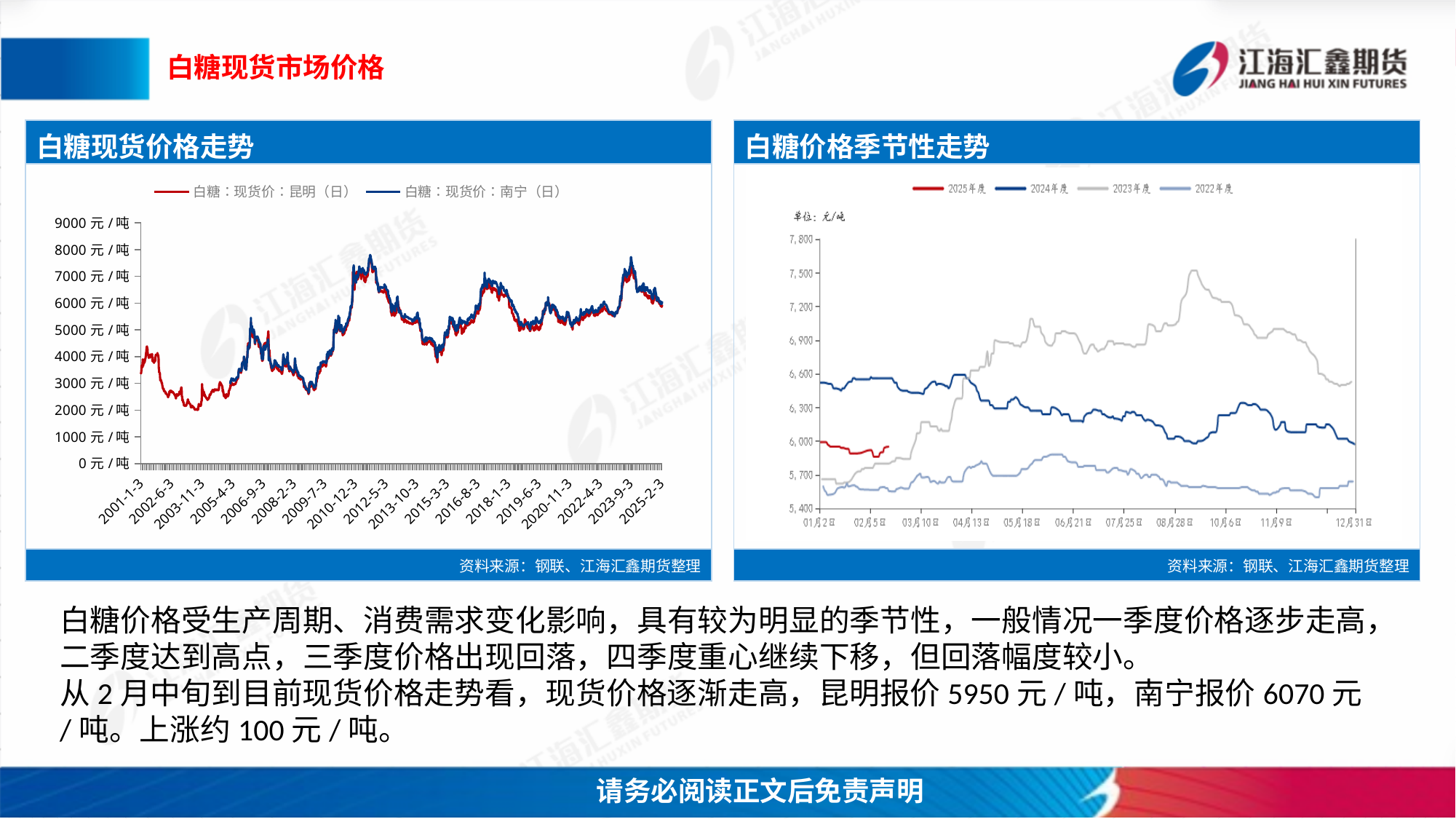
What unit is shown on the y axis of the 白糖现货价格走势 chart? 元/吨 In the 白糖价格季节性走势 chart, which year's line reaches the highest value? 2023年度 How many series does the legend of the 白糖价格季节性走势 chart list? 4 In the 白糖价格季节性走势 chart, is the 2022年度 value at 01月2日 greater or less than 6,000? less In the 白糖现货价格走势 chart, which series is drawn in red? 白糖：现货价：昆明（日） In the 白糖价格季节性走势 chart, which year's line is the lowest for most of the year? 2022年度 In the 白糖现货价格走势 chart, is the peak value around 2010-12-3 greater or less than 7000 元/吨? greater In the 白糖现货价格走势 chart, is the value around 2003-11-3 greater or less than 3000 元/吨? less What kind of chart is the 白糖现货价格走势 chart on the left? line chart In the 白糖现货价格走势 chart, do the prices rise or fall between 2003-11-3 and 2010-12-3? rise How many series does the legend of the 白糖现货价格走势 chart list? 2